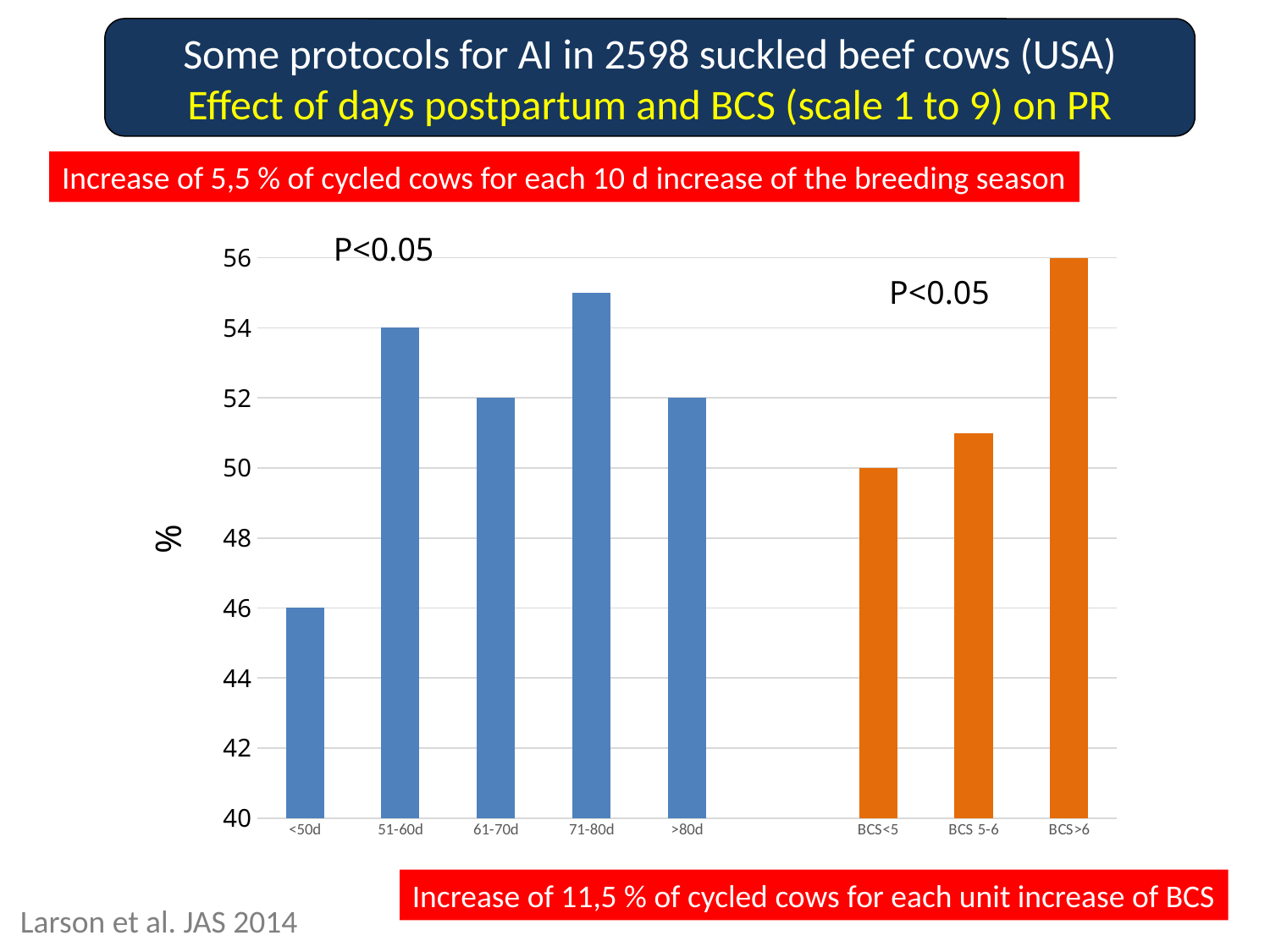
How many bars (categories) are plotted in the chart? 8 Which is larger, the value for 61-70d or the value for BCS<5? 61-70d What is the value for the BCS<5 category? 50 What is the value for the <50d category? 46 What is the value for the 51-60d category? 54 Is the value for 71-80d greater or less than 54? greater What is the value for the BCS>6 category? 56 What is the difference between the values for 51-60d and <50d? 8 Which category has the highest value in the chart? BCS>6 What kind of chart is shown on the slide? bar chart Which category has the lowest value in the chart? <50d Is the value for BCS 5-6 greater or less than 52? less